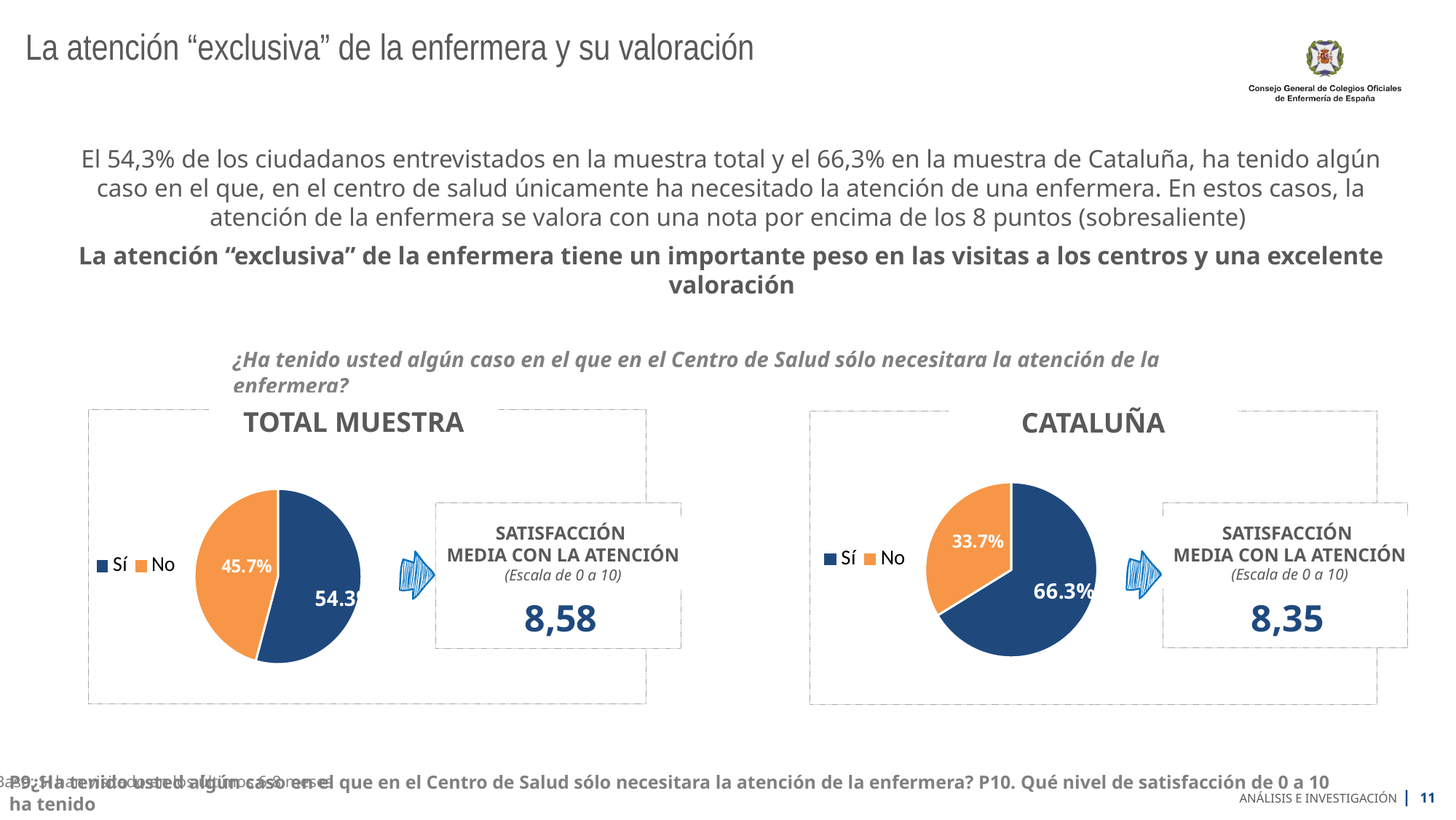
In the CATALUÑA pie chart, what is the difference between the Sí and No shares? 32.6 percentage points Which colour represents the No answer in the pie charts? Orange What type of chart is used for TOTAL MUESTRA and CATALUÑA? Pie chart In the TOTAL MUESTRA pie chart, what percentage of respondents answered No? 45.7% In the CATALUÑA pie chart, what percentage of respondents answered No? 33.7% In the CATALUÑA pie chart, what percentage of respondents answered Sí? 66.3% Is the No share in the CATALUÑA pie chart greater or less than the No share in the TOTAL MUESTRA pie chart? less How many entries does the legend of the TOTAL MUESTRA pie chart list? 2 In the CATALUÑA pie chart, which answer has the smallest share? No How many slices does the CATALUÑA pie chart have? 2 In the TOTAL MUESTRA pie chart, what is the difference between the Sí and No shares? 8.6 percentage points In the TOTAL MUESTRA pie chart, which answer has the larger share, Sí or No? Sí